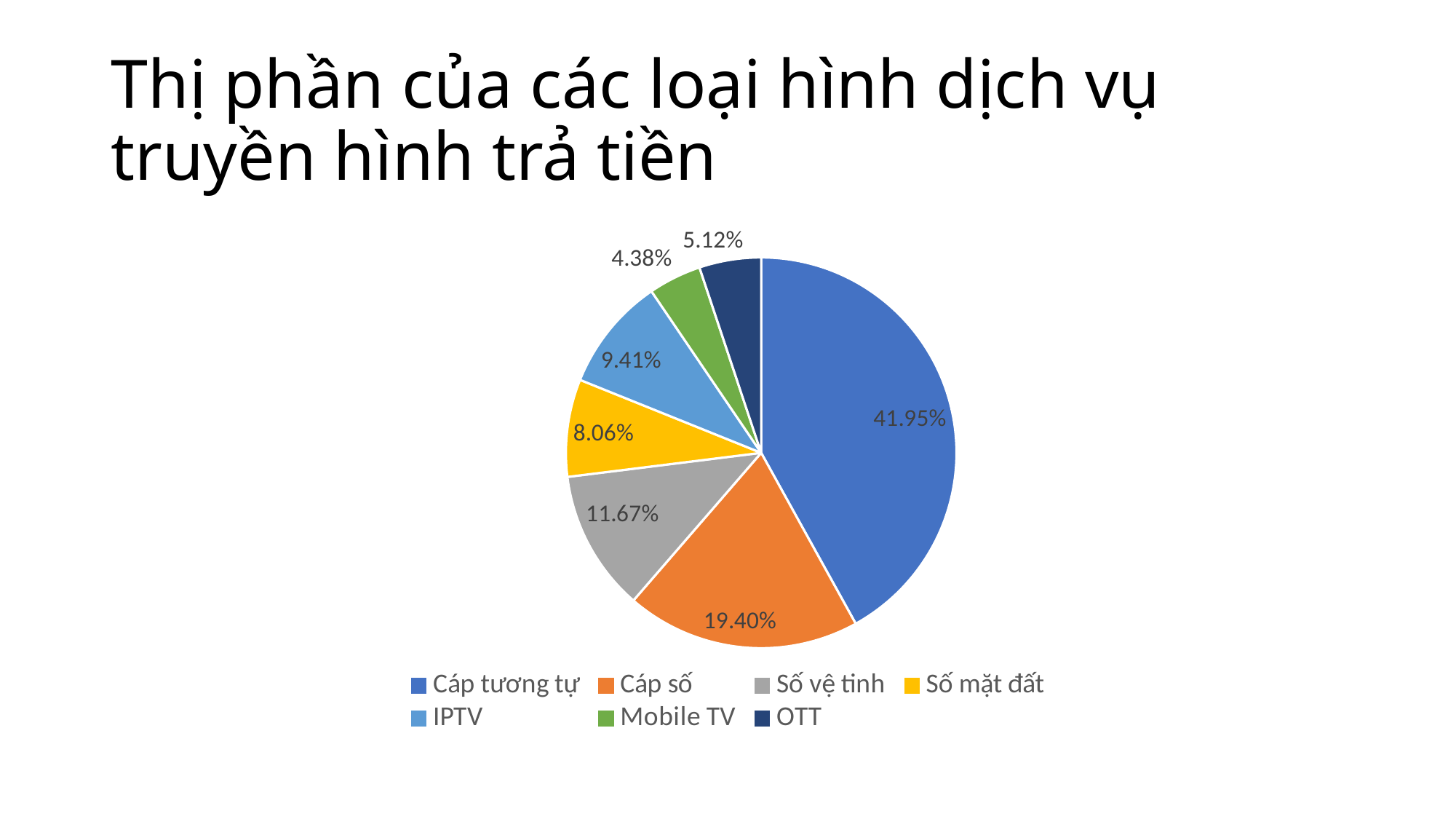
How many categories does the pie chart have? 7 Which category has the largest slice of the pie? Cáp tương tự What is the value shown for Cáp số? 19.40% What is the title of the chart on the slide? Thị phần của các loại hình dịch vụ truyền hình trả tiền What share of the pie does Cáp tương tự hold? 41.95% Which is larger, the share of Số mặt đất or the share of IPTV? IPTV What is the value shown for Mobile TV? 4.38% What is the value shown for Số vệ tinh? 11.67% What is the value shown for IPTV? 9.41% What is the difference between the shares of Cáp tương tự and Cáp số? 22.55% What kind of chart is shown on the slide? Pie chart Which category has the smallest slice of the pie? Mobile TV